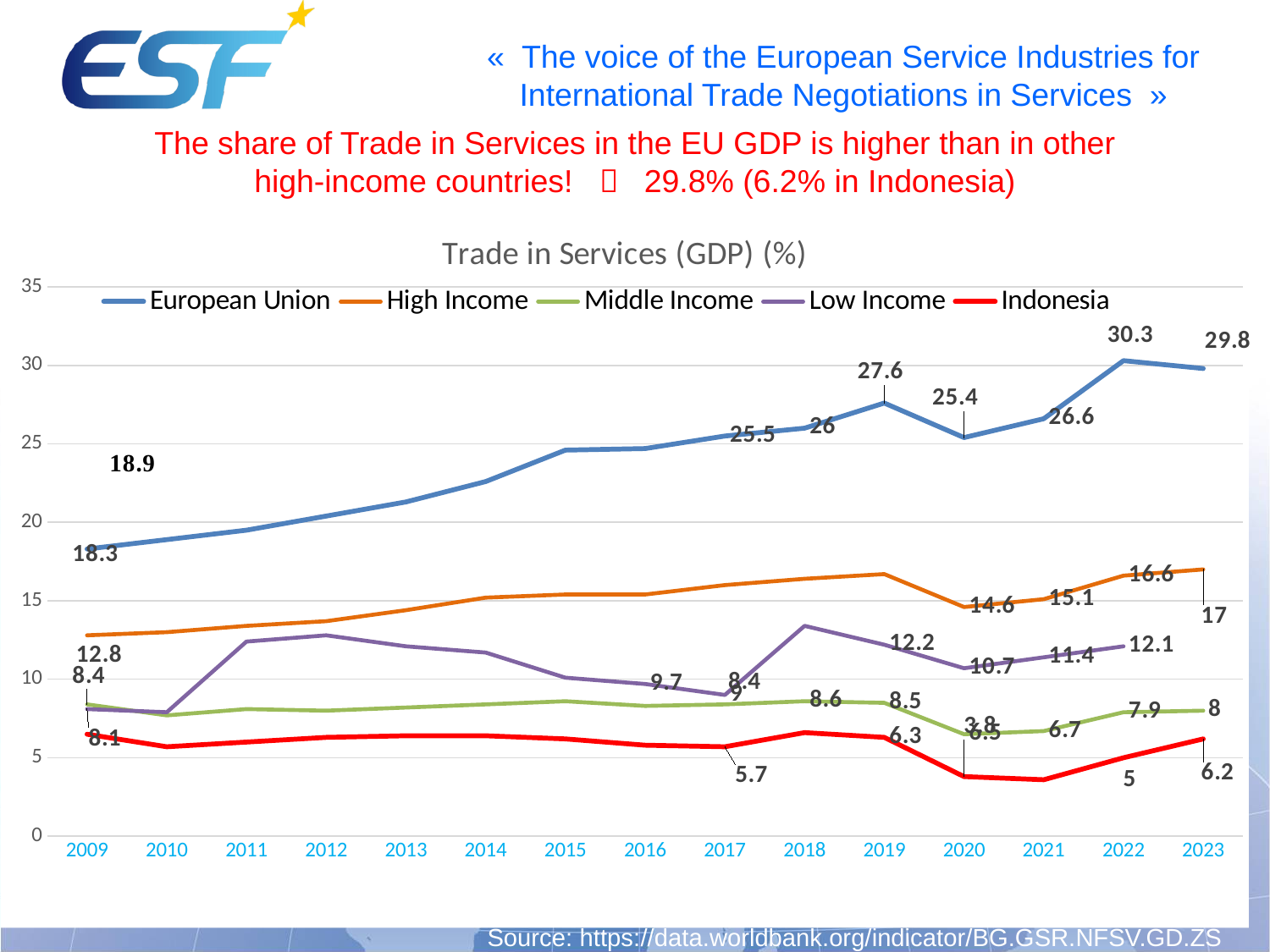
What is the value for Indonesia in 2023? 6.2 How many years are shown on the x axis? 15 What is the title of the chart? Trade in Services (GDP) (%) What is the difference between the European Union and Indonesia values in 2023? 23.6 Does the European Union series rise or fall from 2009 to 2019? rise How many series does the legend list? 5 What type of chart is shown on the slide? line chart Is the value for Low Income in 2011 greater or less than 10? greater Which is larger for the European Union: the value in 2019 or the value in 2020? 2019 What is the value for the European Union in 2023? 29.8 What is the value for High Income in 2023? 17 In which year does the European Union series reach its highest value? 2022